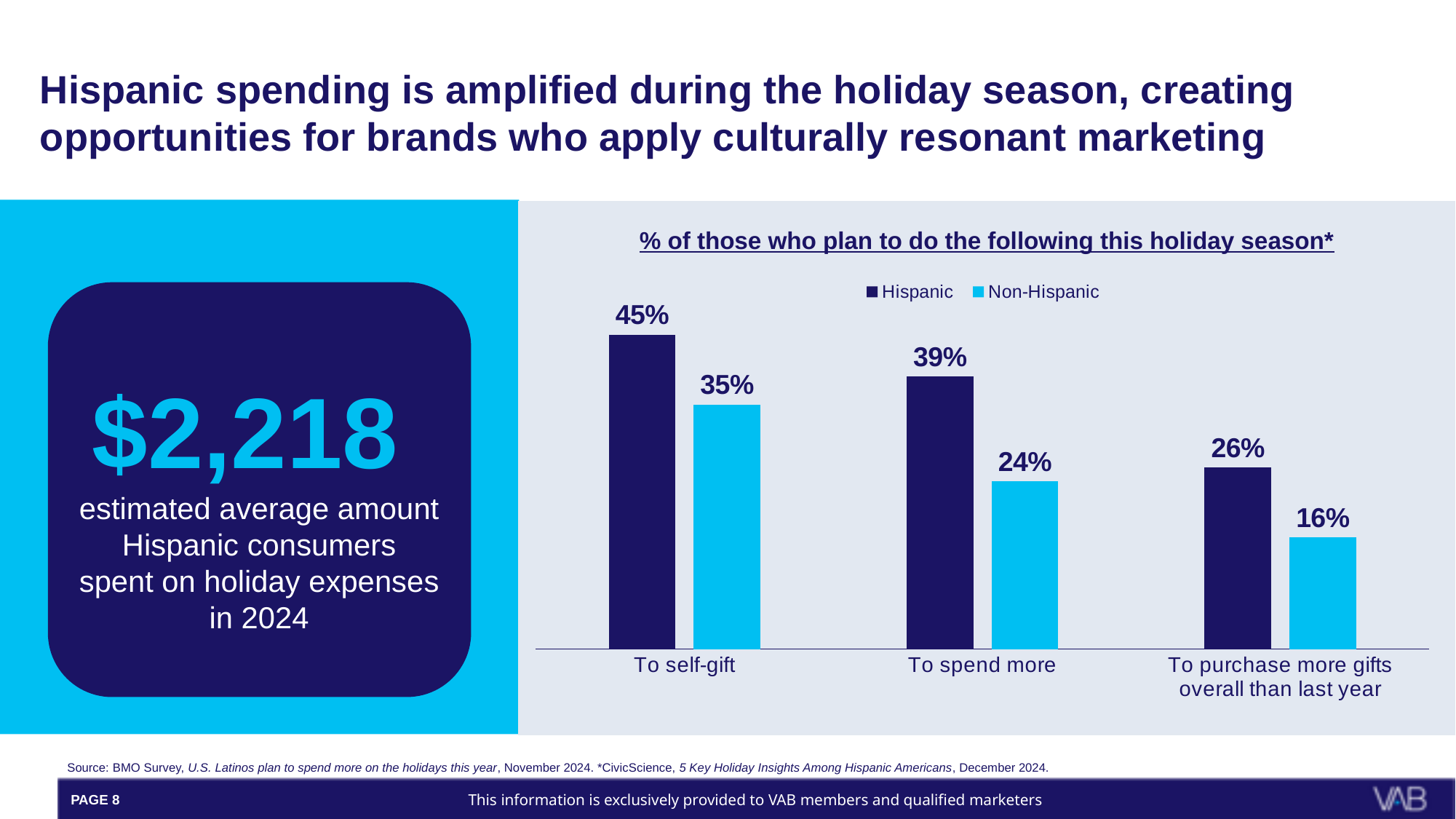
How many categories are shown on the x axis of the chart? 3 Which category has the lowest Non-Hispanic value? To purchase more gifts overall than last year What percentage of Hispanic respondents plan to self-gift this holiday season? 45% Which category has the highest Hispanic value? To self-gift How many series does the chart legend list? 2 What is the title of the chart? % of those who plan to do the following this holiday season* What is the Non-Hispanic value for 'To purchase more gifts overall than last year'? 16% What kind of chart is shown on the slide? Bar chart What is the difference between the Hispanic and Non-Hispanic values for 'To spend more'? 15 percentage points What is the difference between the Hispanic and Non-Hispanic values for 'To self-gift'? 10 percentage points What percentage of Non-Hispanic respondents plan to spend more this holiday season? 24% Which is larger: the Hispanic value for 'To purchase more gifts overall than last year' or the Non-Hispanic value for 'To spend more'? Hispanic value for 'To purchase more gifts overall than last year'